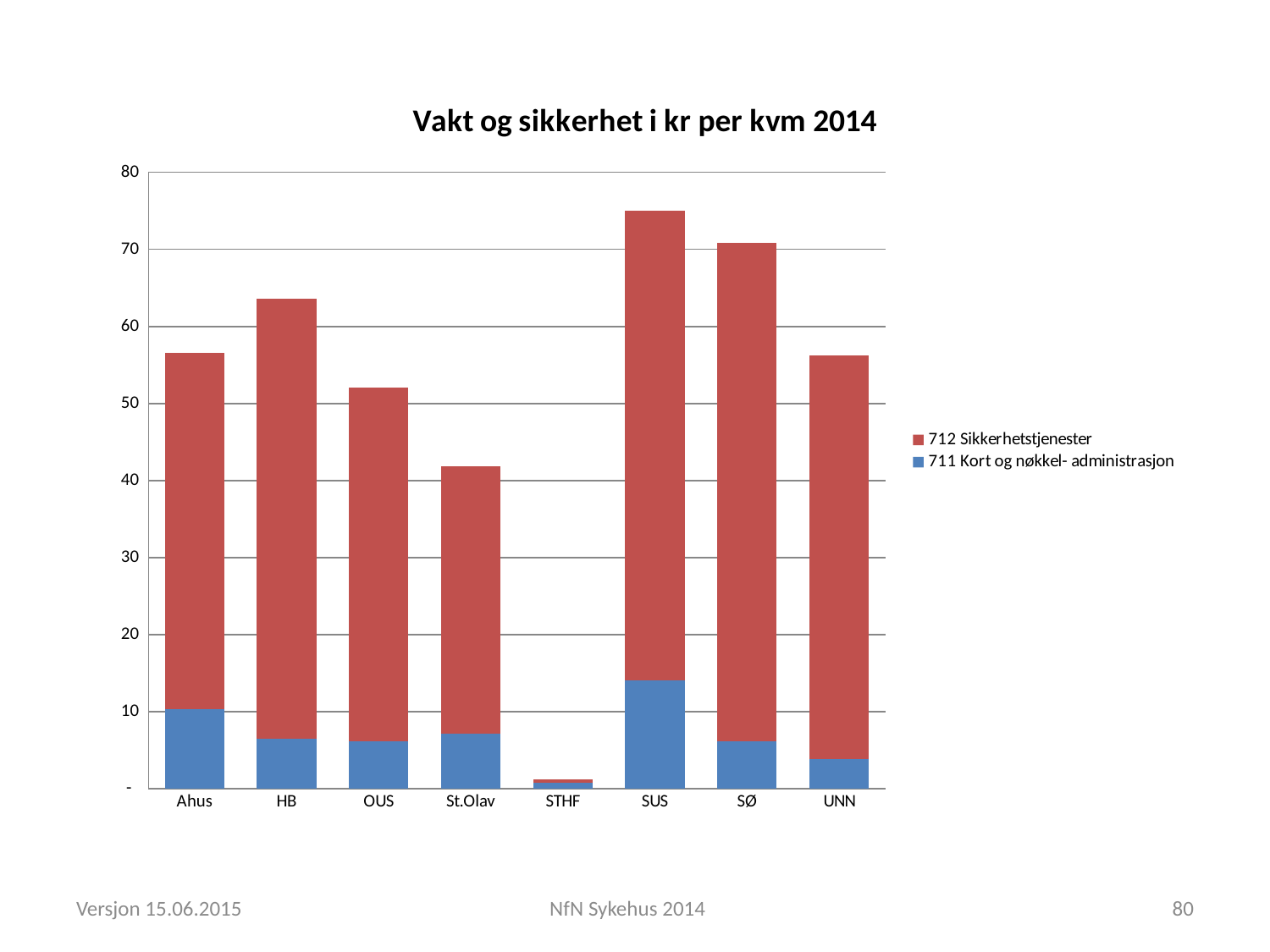
What kind of chart is shown on the slide? stacked bar chart Which hospital has the largest 711 Kort og nøkkel- administrasjon segment? SUS Is the total value for STHF greater or less than 10? less Which series is shown in red? 712 Sikkerhetstjenester How many series does the legend list? 2 Which hospital has the highest total bar? SUS Is the total value for St.Olav greater or less than 50? less How many hospitals (categories) are shown on the x axis? 8 Which has the larger total bar, HB or OUS? HB Which hospital has the lowest total bar? STHF What is the title of the chart? Vakt og sikkerhet i kr per kvm 2014 Is the total value for SUS greater or less than 70? greater